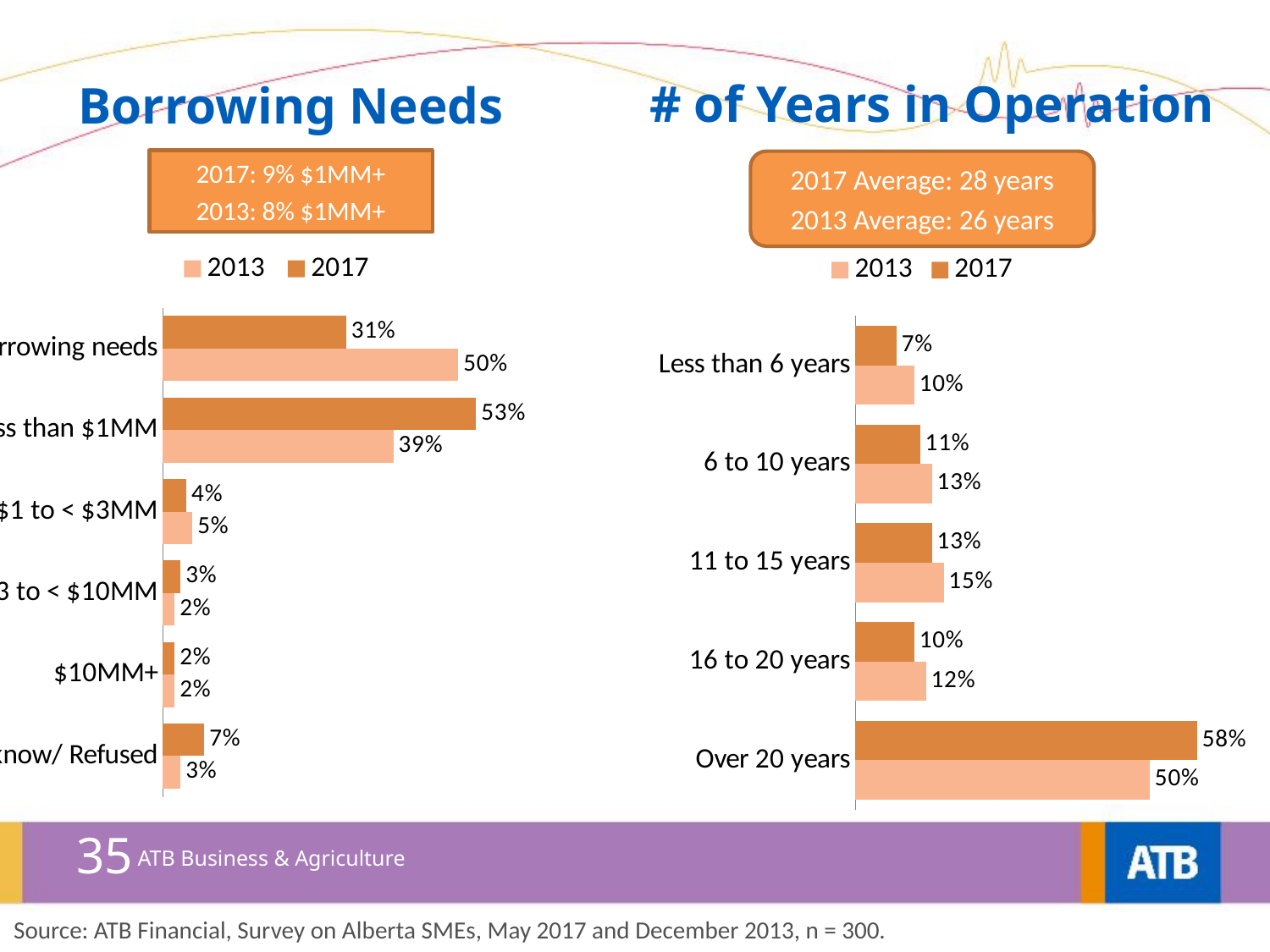
How many categories does the '# of Years in Operation' chart show? 5 In the '# of Years in Operation' chart, what is the 2017 value for 'Over 20 years'? 58% According to the text box above the '# of Years in Operation' chart, what was the 2017 average number of years in operation? 28 years In the '# of Years in Operation' chart, which category has the highest 2017 value? Over 20 years In the 'Borrowing Needs' chart, what is the 2017 value for '$10MM+'? 2% In the '# of Years in Operation' chart, is the 2013 value for '16 to 20 years' larger or smaller than the 2017 value? larger What kind of chart is the 'Borrowing Needs' chart? bar chart In the '# of Years in Operation' chart, which category has the lowest 2017 value? Less than 6 years In the '# of Years in Operation' chart, what is the 2017 value for '11 to 15 years'? 13% In the '# of Years in Operation' chart, what is the 2013 value for 'Less than 6 years'? 10% How many series does the legend of the '# of Years in Operation' chart list? 2 In the '# of Years in Operation' chart, what is the difference between the 2017 and 2013 values for 'Over 20 years'? 8%